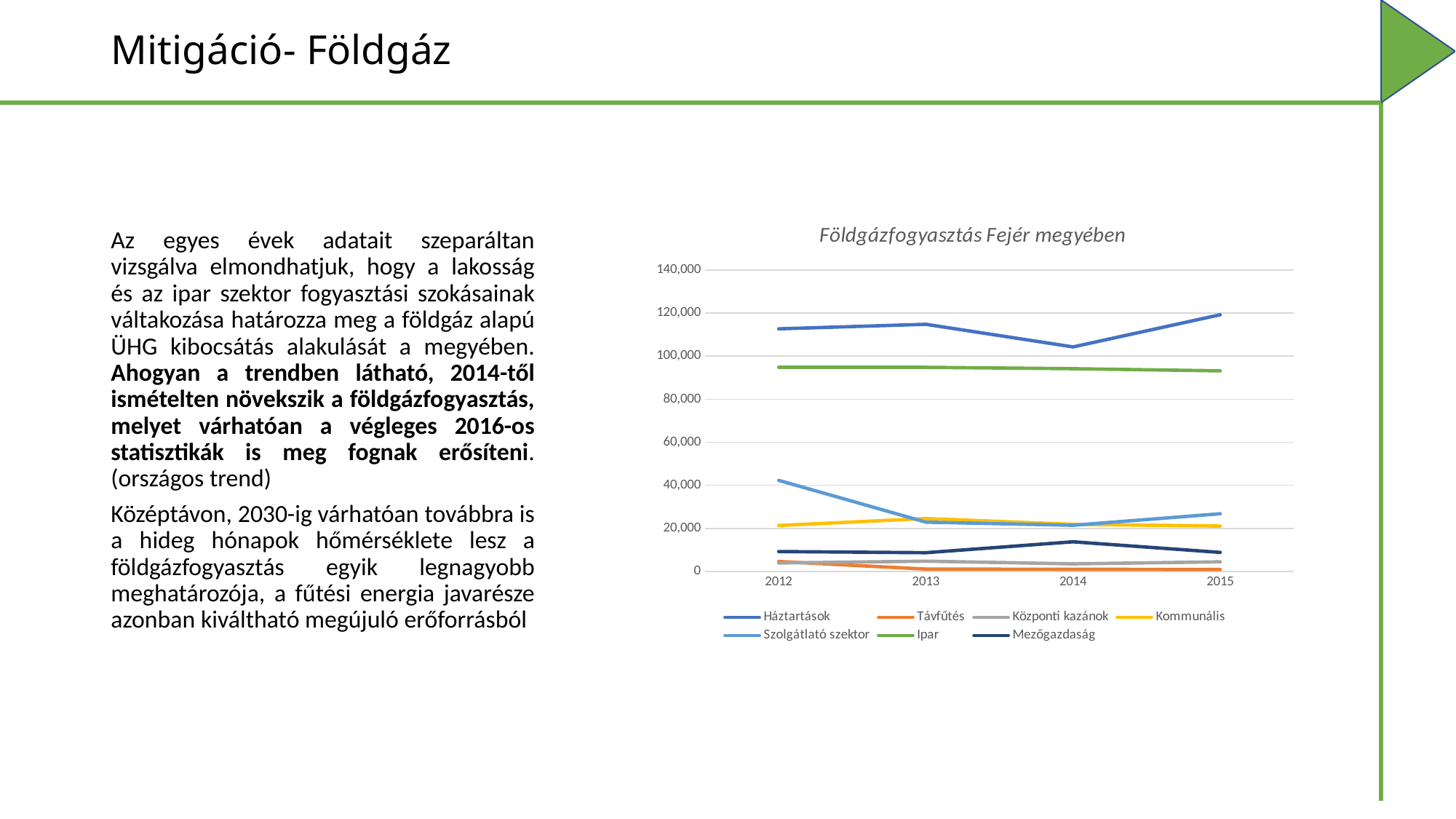
In which year is the Szolgáltató szektor value highest? 2012 How many series does the chart's legend list? 7 Is the value for Mezőgazdaság in 2014 greater or less than 20,000? less Is the value for Ipar in 2015 greater or less than 100,000? less In which year is the Háztartások value highest? 2015 Which series has the highest values across all years in the chart? Háztartások How many years are shown on the x axis of the chart? 4 Does the Szolgáltató szektor line rise or fall from 2012 to 2014? Falls Is the value for Háztartások in 2015 greater or less than 100,000? greater What kind of chart is shown on the slide? Line chart What is the title of the chart? Földgázfogyasztás Fejér megyében Which series has the lowest values in 2015? Távfűtés